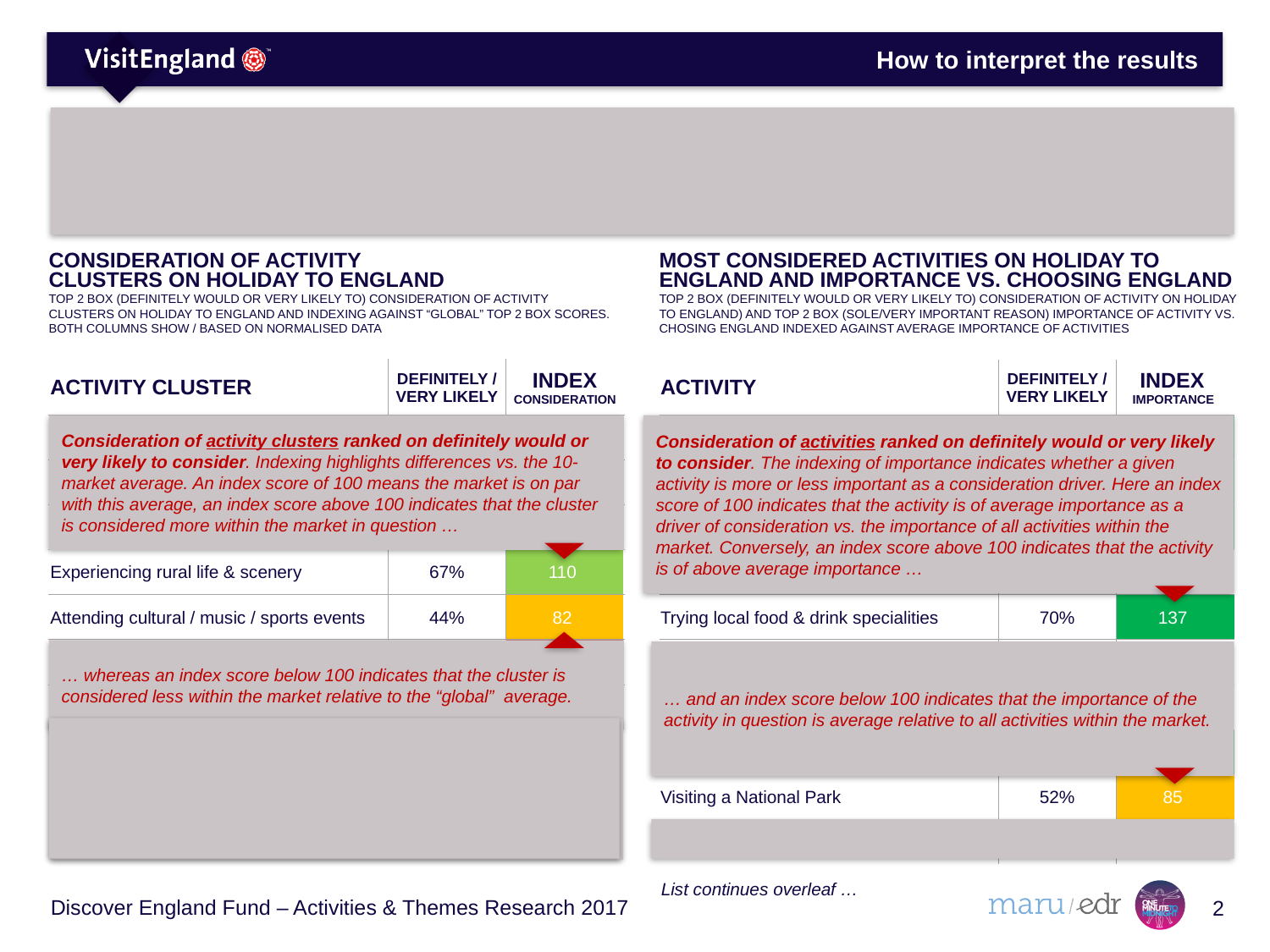
In the left table (Consideration of Activity Clusters on Holiday to England), which activity cluster has the higher Definitely / Very Likely percentage? Experiencing rural life & scenery In the left table (Consideration of Activity Clusters on Holiday to England), what is the Index Consideration score for Attending cultural / music / sports events? 82 In the right table (Most Considered Activities on Holiday to England), what is the Definitely / Very Likely value for Trying local food & drink specialities? 70% In the left table (Consideration of Activity Clusters on Holiday to England), what is the Index Consideration score for Experiencing rural life & scenery? 110 How many activity rows with data are shown in the left table (Consideration of Activity Clusters on Holiday to England)? 2 In the right table (Most Considered Activities on Holiday to England), is the Definitely / Very Likely value larger for Trying local food & drink specialities or for Visiting a National Park? Trying local food & drink specialities In the right table (Most Considered Activities on Holiday to England), what is the Index Importance score for Visiting a National Park? 85 In the left table (Consideration of Activity Clusters on Holiday to England), what is the Definitely / Very Likely value for Experiencing rural life & scenery? 67% In the right table (Most Considered Activities on Holiday to England), what is the Index Importance score for Trying local food & drink specialities? 137 In the left table (Consideration of Activity Clusters on Holiday to England), what is the difference in Definitely / Very Likely percentage between Experiencing rural life & scenery and Attending cultural / music / sports events? 23 percentage points In the right table (Most Considered Activities on Holiday to England), what is the difference between the Index Importance scores of Trying local food & drink specialities and Visiting a National Park? 52 In the right table (Most Considered Activities on Holiday to England), which activity has the lower Index Importance score? Visiting a National Park